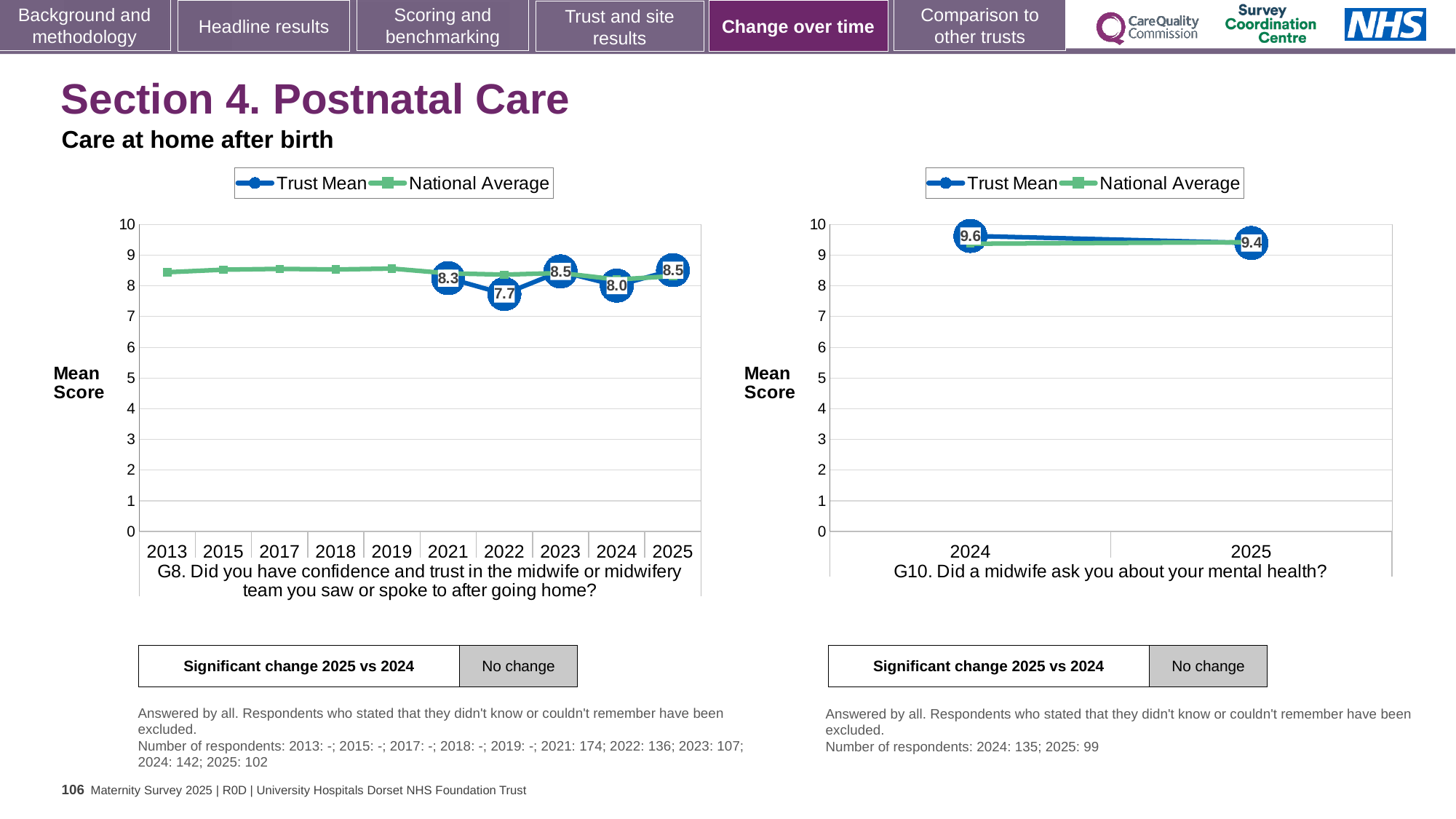
In the G8 chart, which year has the lowest labelled Trust Mean? 2022 How many series does the legend of the G10 chart list? 2 In the G10 chart, what is the difference between the Trust Mean for 2024 and the Trust Mean for 2025? 0.2 In the G8 chart, is the Trust Mean for 2024 larger or smaller than the Trust Mean for 2025? smaller In the G8 chart, is the National Average for 2013 greater or less than 8? greater In the G10 chart, does the Trust Mean rise or fall from 2024 to 2025? fall In the G10 chart, what is the Trust Mean for 2024? 9.6 In the G8 chart, what is the difference between the Trust Mean for 2023 and the Trust Mean for 2022? 0.8 In the G8 chart, how many years are shown on the x axis? 10 In the G8 chart, what is the Trust Mean for 2024? 8.0 In the G8 chart, what is the Trust Mean for 2021? 8.3 In the G8 chart, what is the Trust Mean for 2022? 7.7